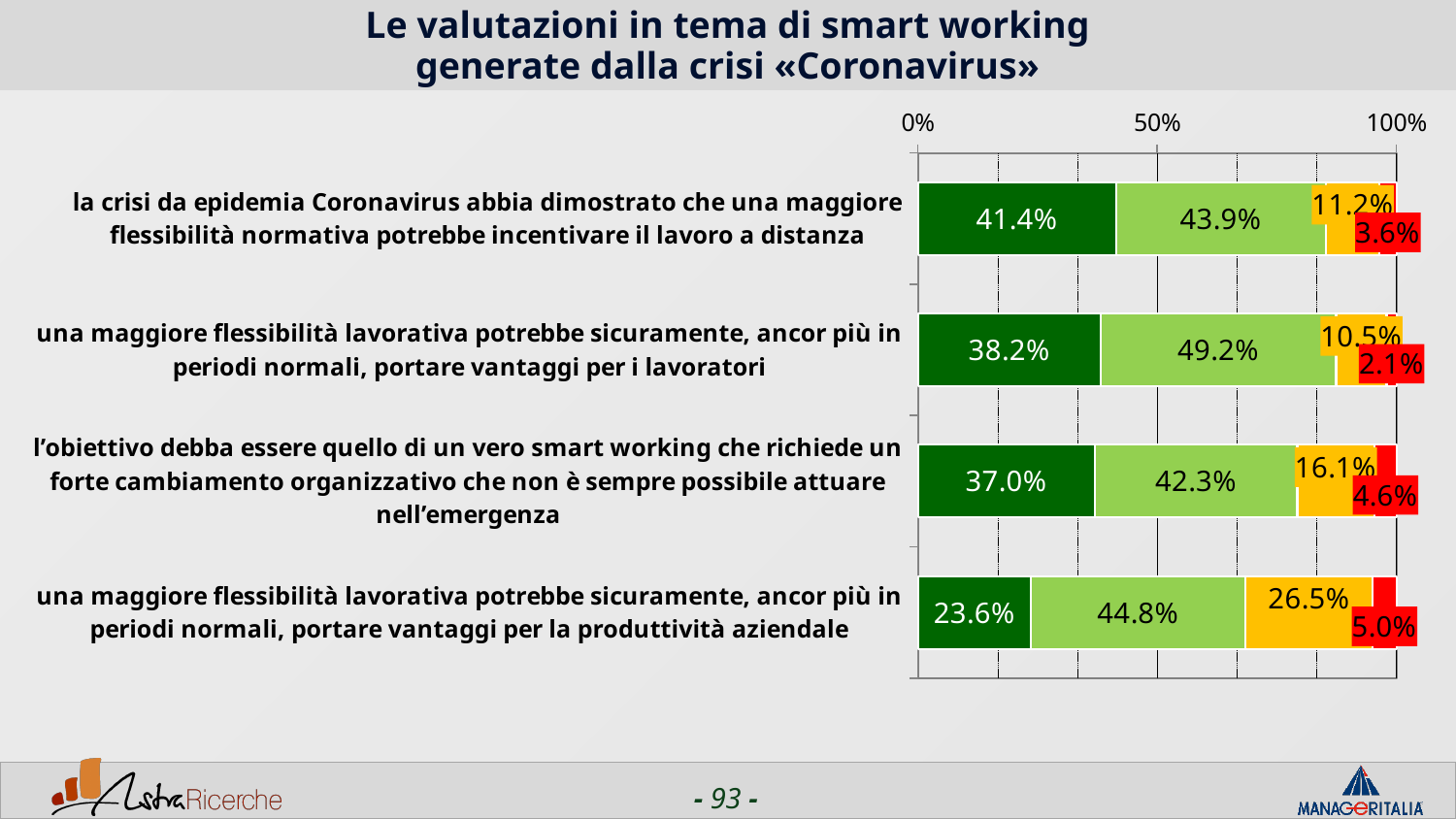
Is the dark green segment for the statement about the Coronavirus crisis and regulatory flexibility greater or less than 50%? less What is the value of the dark green segment for the statement about the Coronavirus crisis showing that greater regulatory flexibility could encourage remote work? 41.4% What is the difference between the yellow segment values for the 'produttività aziendale' statement (26.5%) and the 'per i lavoratori' statement (10.5%)? 16.0% What is the value of the red segment for the statement about the goal being a true smart working that requires strong organisational change? 4.6% What is the value of the yellow segment for the statement about greater work flexibility bringing advantages for company productivity ('produttività aziendale')? 26.5% What is the title of the slide containing the chart? Le valutazioni in tema di smart working generate dalla crisi «Coronavirus» What is the value of the light green segment for the statement about greater work flexibility bringing advantages for workers ('per i lavoratori')? 49.2% Which statement has the highest dark green value? la crisi da epidemia Coronavirus abbia dimostrato che una maggiore flessibilità normativa potrebbe incentivare il lavoro a distanza What type of chart is shown on the slide? stacked bar chart Which is larger: the red segment for the 'produttività aziendale' statement or the red segment for the 'per i lavoratori' statement? produttività aziendale (5.0%) How many statements (categories) are plotted in the chart? 4 Which statement has the lowest dark green value? una maggiore flessibilità lavorativa potrebbe sicuramente, ancor più in periodi normali, portare vantaggi per la produttività aziendale